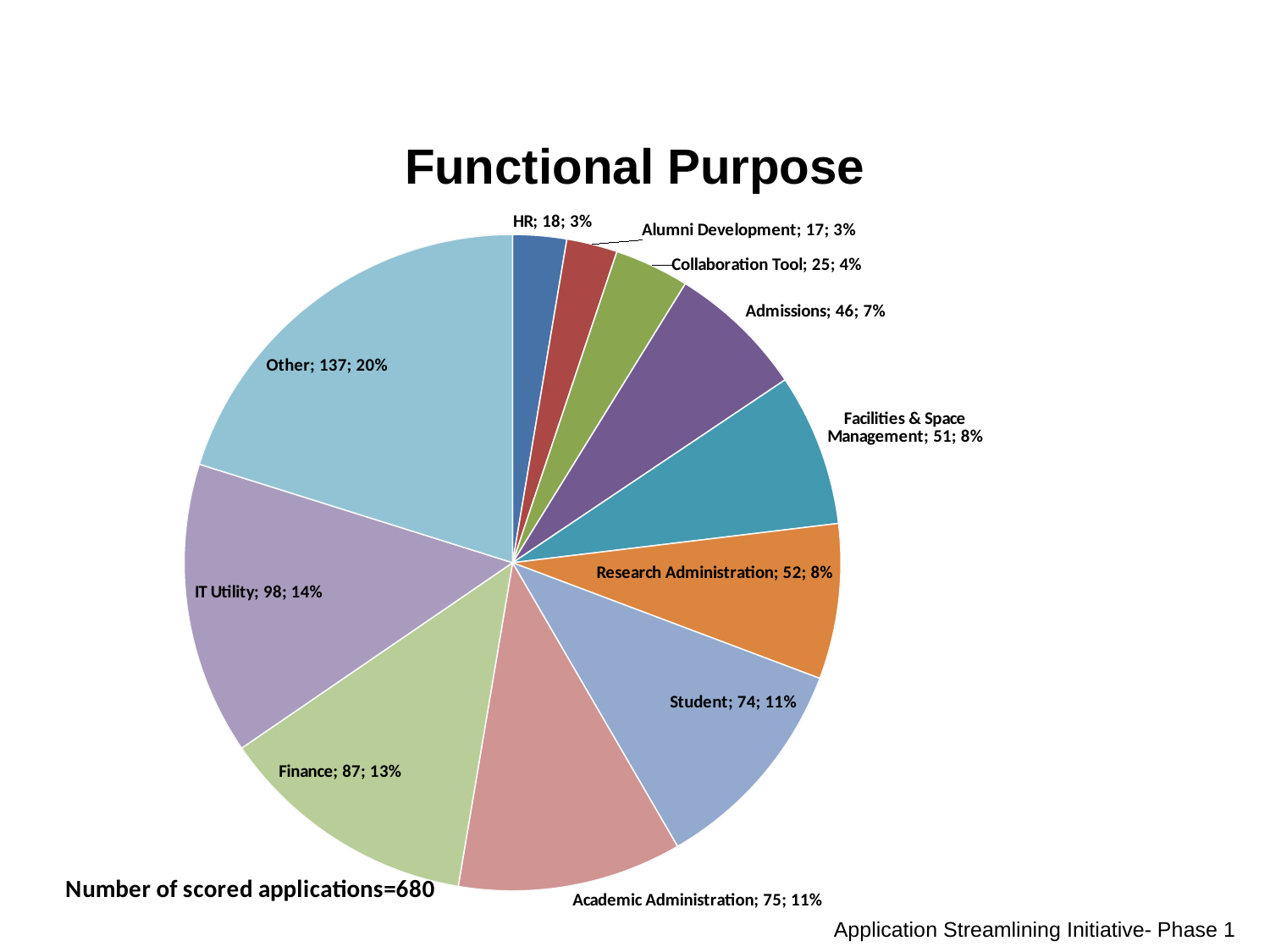
What percentage share does the IT Utility slice represent? 14% How many applications are in the Finance slice? 87 What is the title of the chart? Functional Purpose What percentage share does the Collaboration Tool slice represent? 4% Which category has the smallest slice of the pie? Alumni Development Which has more applications, Student or Admissions? Student How many slices does the pie chart have? 11 What type of chart is shown on the slide? pie chart Which category has the largest slice of the pie? Other What is the difference in count between Other and IT Utility? 39 What is the total number of scored applications stated on the slide? 680 What is the count for Facilities & Space Management? 51